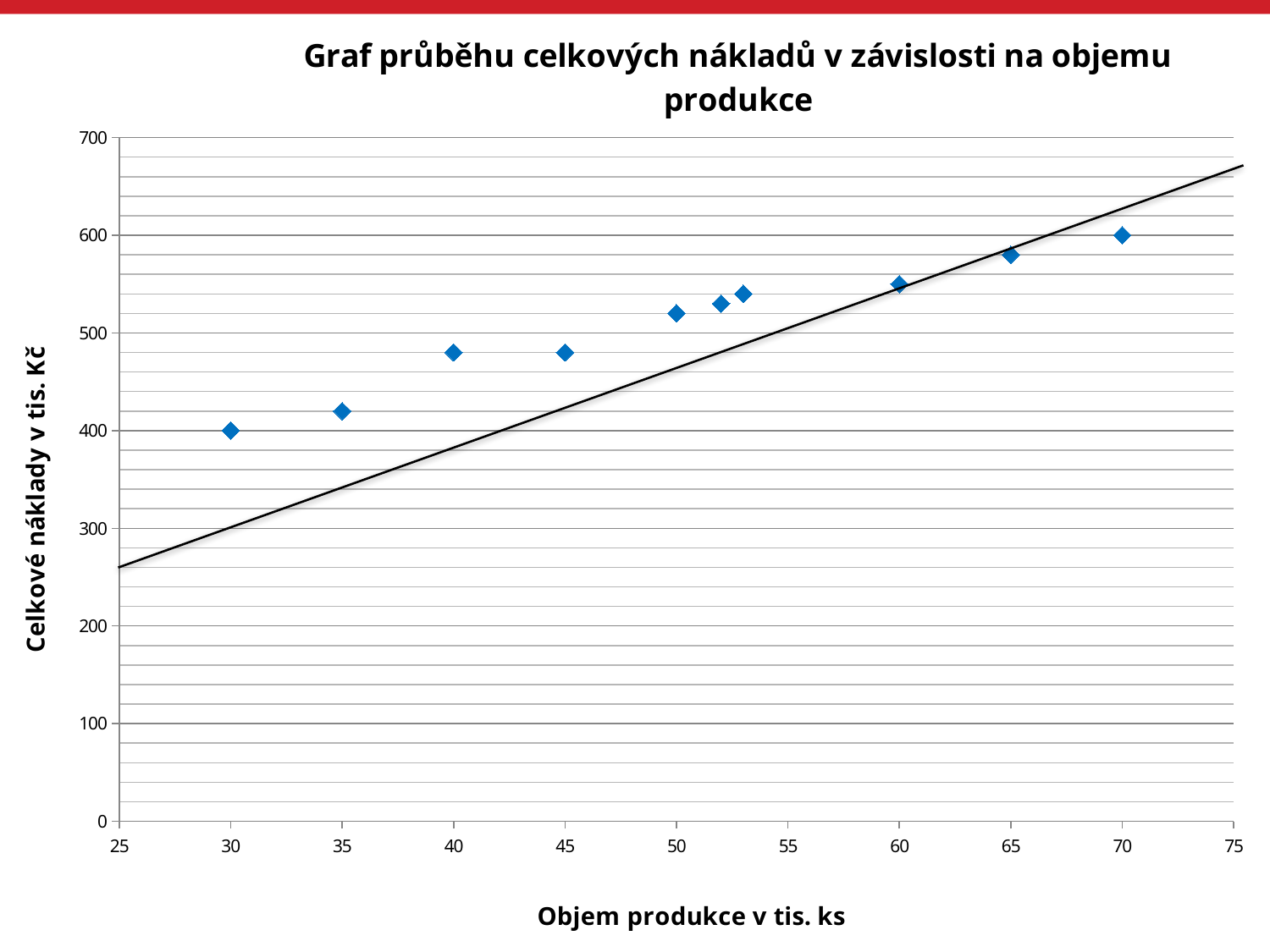
What kind of chart is shown on the slide? scatter chart Is the total cost at a production volume of 35 tis. ks greater or less than 500? less What is the total cost value (Celkové náklady) at a production volume of 70 tis. ks? 600 What is the label of the vertical axis? Celkové náklady v tis. Kč At which production volume (Objem produkce) is the total cost highest? 70 Is the total cost at a production volume of 60 tis. ks greater or less than 500? greater Is the total cost at a production volume of 40 tis. ks greater or less than 400? greater Do the total costs rise or fall as the production volume increases along the x axis? rise At which production volume (Objem produkce) is the total cost lowest? 30 How many data points are plotted on the chart? 10 Which has the higher total cost: a production volume of 40 tis. ks or 60 tis. ks? 60 What is the total cost value (Celkové náklady) at a production volume of 30 tis. ks? 400